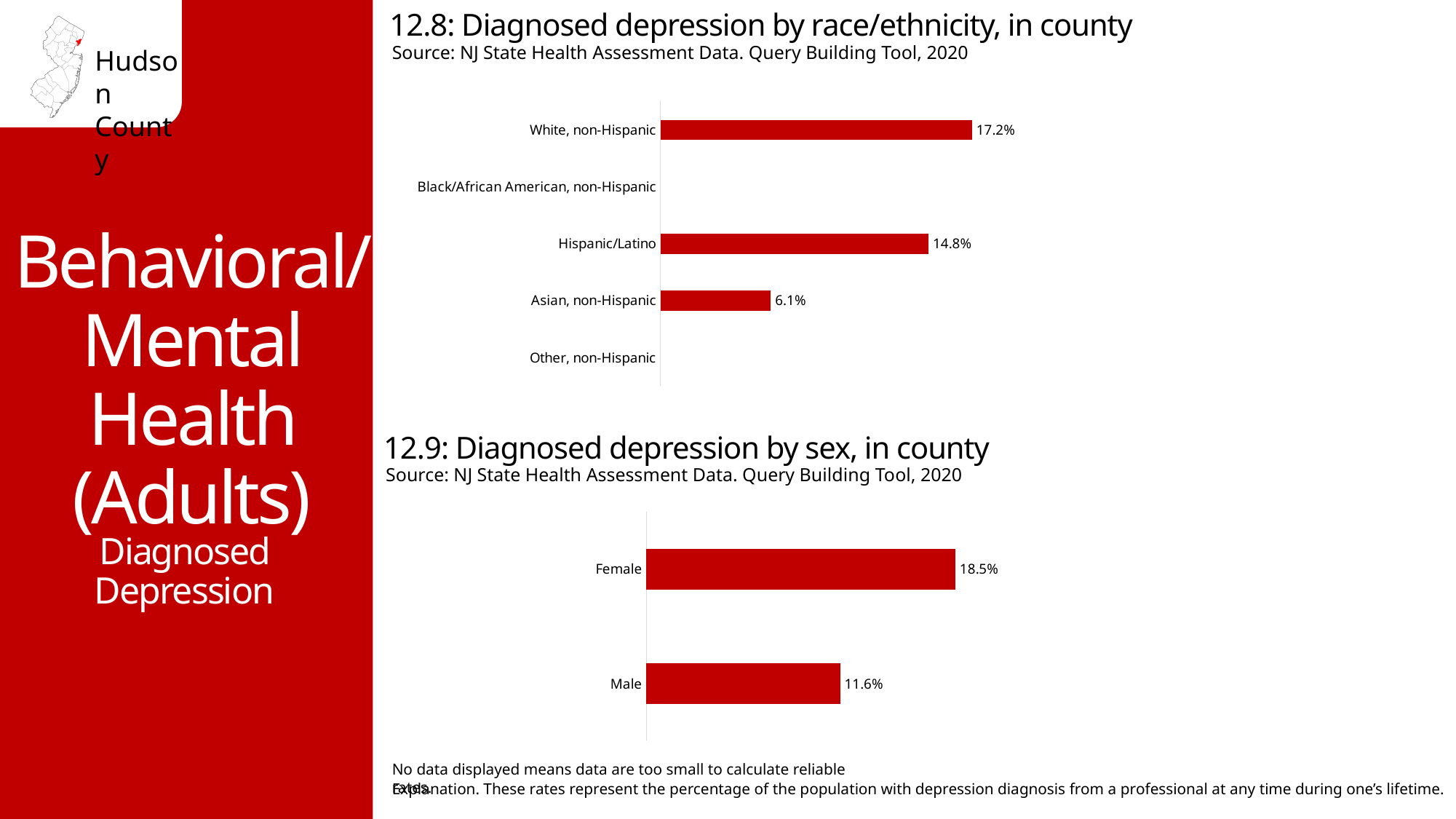
What kind of chart is '12.9: Diagnosed depression by sex, in county'? Bar chart In the chart '12.9: Diagnosed depression by sex, in county', what is the value for Male? 11.6% In the chart '12.8: Diagnosed depression by race/ethnicity, in county', what is the value for Asian, non-Hispanic? 6.1% In the chart '12.8: Diagnosed depression by race/ethnicity, in county', which category with a displayed value has the lowest value? Asian, non-Hispanic In the chart '12.8: Diagnosed depression by race/ethnicity, in county', what is the value for Hispanic/Latino? 14.8% In the chart '12.8: Diagnosed depression by race/ethnicity, in county', what is the difference between the values for White, non-Hispanic and Hispanic/Latino? 2.4% In the chart '12.9: Diagnosed depression by sex, in county', what is the value for Female? 18.5% In the chart '12.9: Diagnosed depression by sex, in county', which is larger, the value for Female or the value for Male? Female In the chart '12.8: Diagnosed depression by race/ethnicity, in county', which category with a displayed value has the highest value? White, non-Hispanic In the chart '12.8: Diagnosed depression by race/ethnicity, in county', what is the value for White, non-Hispanic? 17.2% In the chart '12.9: Diagnosed depression by sex, in county', what is the difference between the values for Female and Male? 6.9% In the chart '12.8: Diagnosed depression by race/ethnicity, in county', how many race/ethnicity categories are listed on the axis? 5